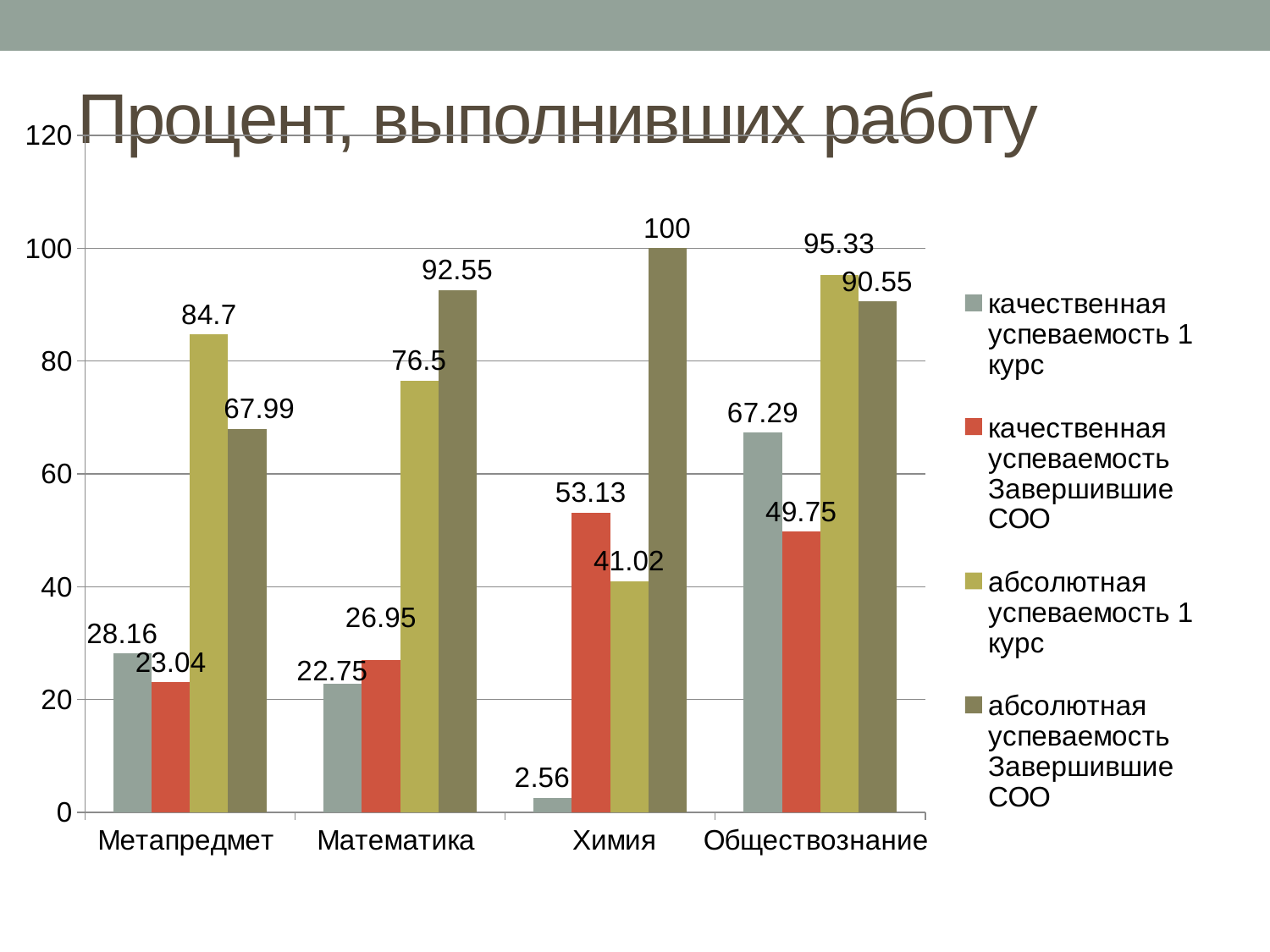
What is the difference between 'абсолютная успеваемость 1 курс' and 'абсолютная успеваемость Завершившие СОО' for Обществознание? 4.78 What is the value of 'качественная успеваемость 1 курс' for Химия? 2.56 Is the value of 'качественная успеваемость 1 курс' for Обществознание greater or less than 60? greater What is the value of 'абсолютная успеваемость 1 курс' for Метапредмет? 84.7 What is the title of the chart? Процент, выполнивших работу How many categories are shown on the x axis? 4 Which category has the lowest value for 'качественная успеваемость 1 курс'? Химия What type of chart is shown on the slide? bar chart Which category has the highest value for 'абсолютная успеваемость Завершившие СОО'? Химия How many series does the legend list? 4 For Химия, which is larger: 'качественная успеваемость Завершившие СОО' or 'абсолютная успеваемость 1 курс'? качественная успеваемость Завершившие СОО What is the value of 'абсолютная успеваемость Завершившие СОО' for Математика? 92.55